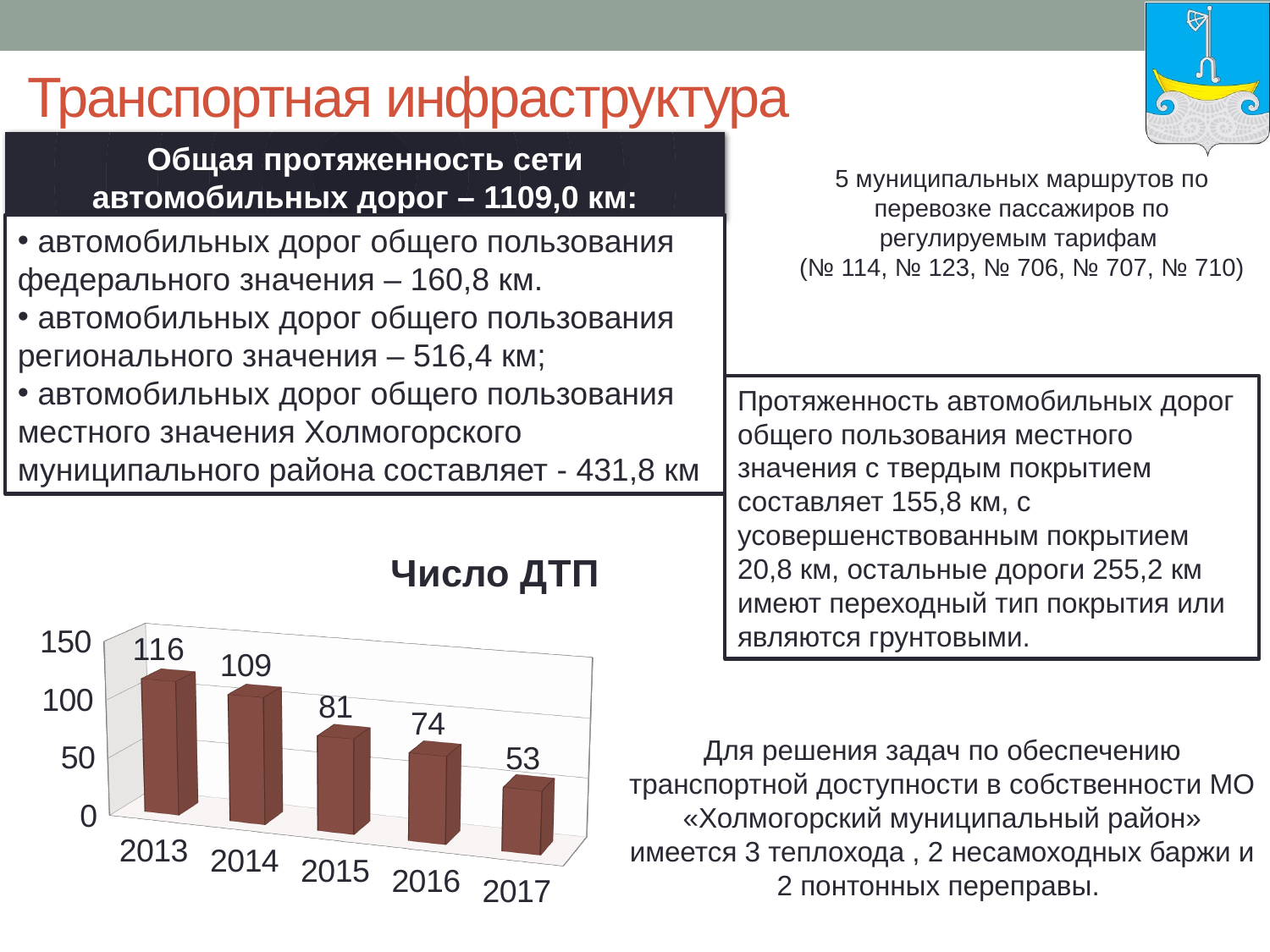
What kind of chart is 'Число ДТП'? bar chart What is the difference between the values for 2014 and 2015 in the 'Число ДТП' chart? 28 Which year has the lowest value in the 'Число ДТП' chart? 2017 Do the values in the 'Число ДТП' chart rise or fall from 2013 to 2017? fall What is the value for 2017 in the 'Число ДТП' chart? 53 Which is larger in the 'Число ДТП' chart, the value for 2014 or the value for 2016? 2014 Is the value for 2016 in the 'Число ДТП' chart greater or less than 100? less What is the value for 2013 in the 'Число ДТП' chart? 116 What is the value for 2015 in the 'Число ДТП' chart? 81 How many years are shown in the 'Число ДТП' chart? 5 Which year has the highest value in the 'Число ДТП' chart? 2013 What is the difference between the values for 2013 and 2017 in the 'Число ДТП' chart? 63